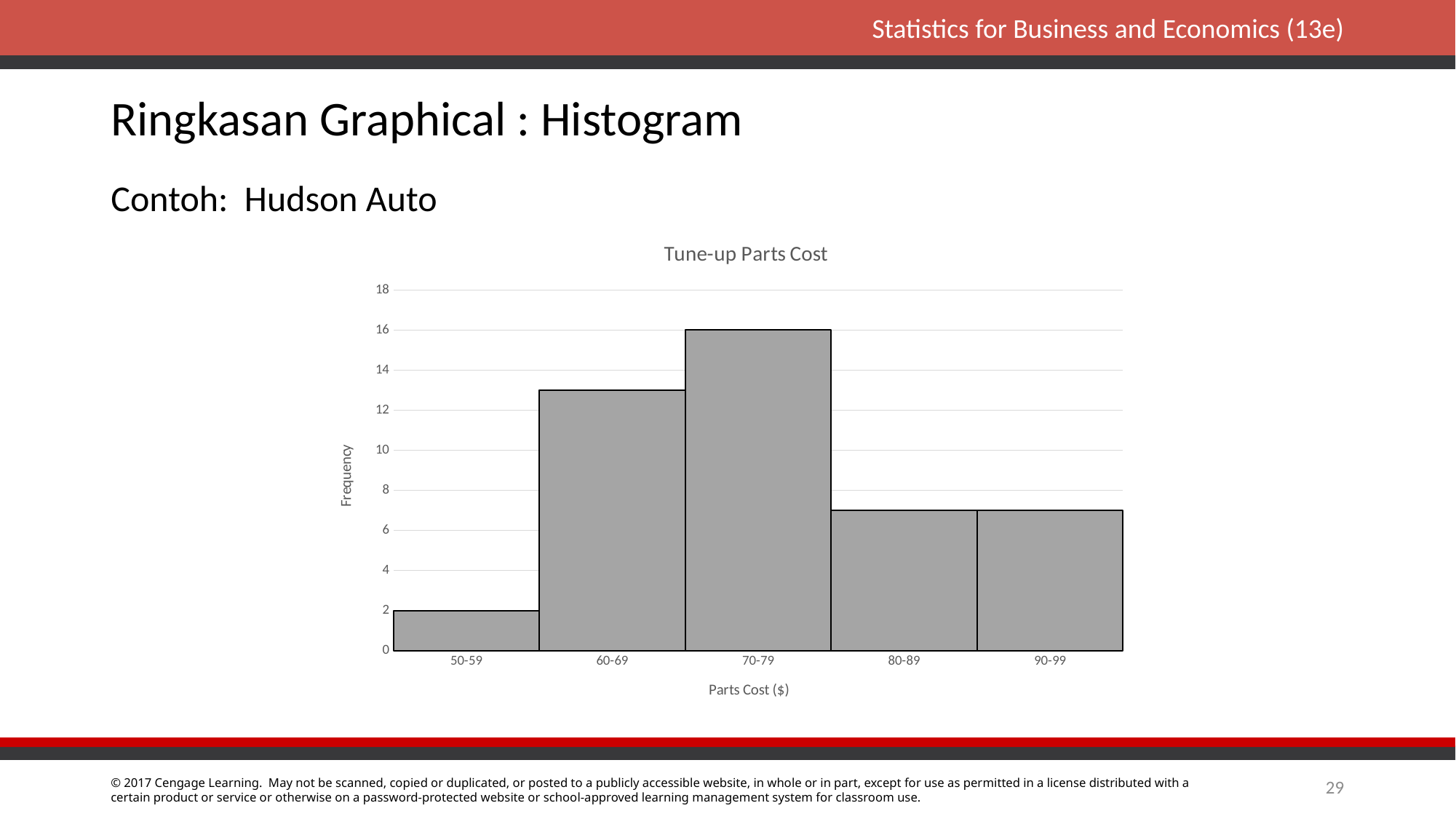
Which parts cost class has the highest frequency? 70-79 What is the title of the chart? Tune-up Parts Cost Is the frequency for the 80-89 class greater or less than 8? less Do the frequencies rise or fall from the 70-79 class to the 90-99 class? Fall What is the frequency for the 50-59 parts cost class? 2 What is the frequency for the 70-79 parts cost class? 16 How many parts cost classes are shown on the x axis? 5 What is the difference in frequency between the 70-79 class and the 50-59 class? 14 Is the frequency for the 60-69 class greater or less than 12? greater Which parts cost class has the lowest frequency? 50-59 What kind of chart is shown on the slide? Bar chart (histogram) Which has a higher frequency, the 60-69 class or the 70-79 class? 70-79